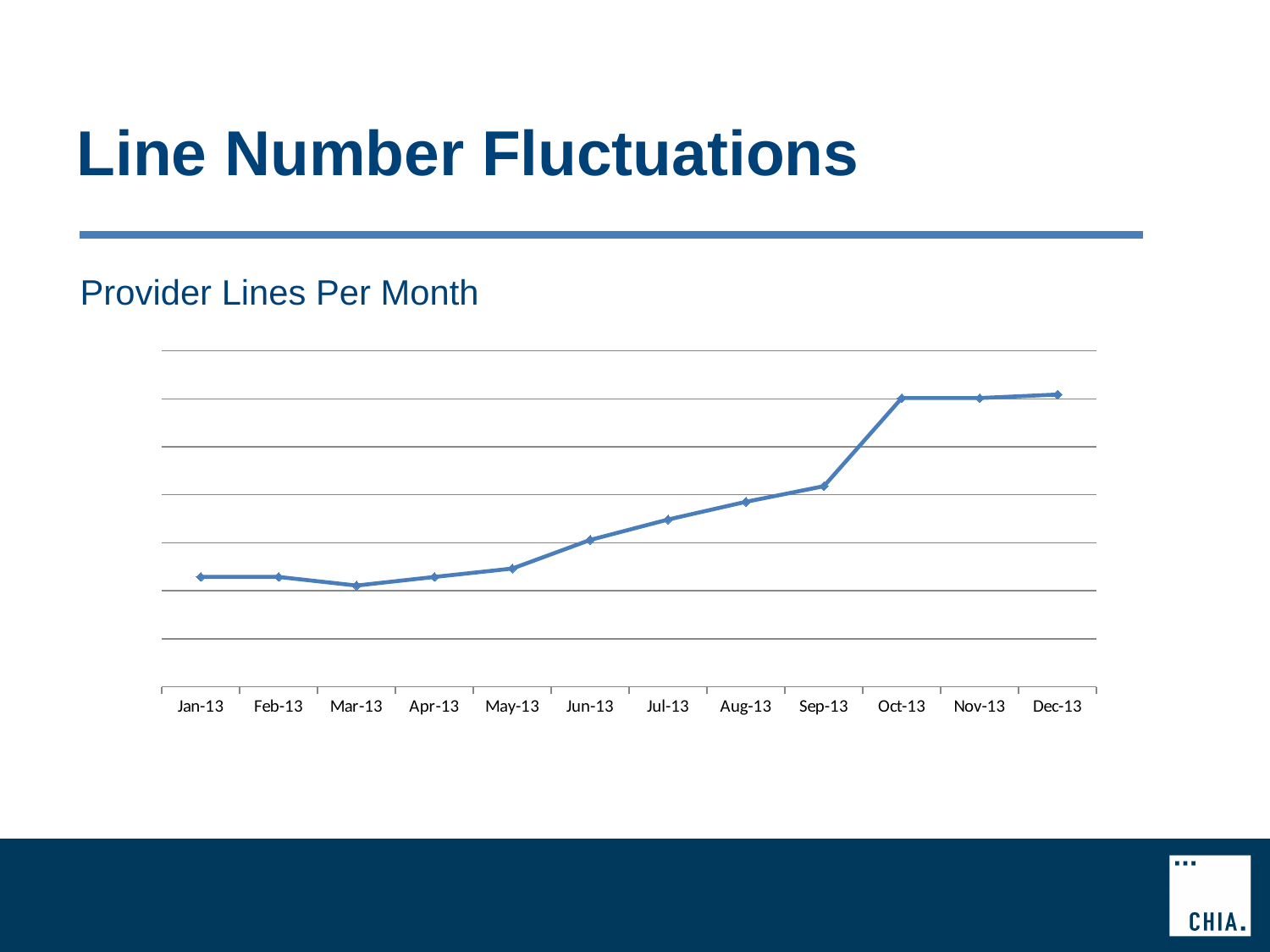
Between which two consecutive months does the line show its steepest increase? Sep-13 to Oct-13 Do the values generally rise or fall from Jan-13 to Dec-13? rise Which is larger, the value for Jan-13 or the value for Oct-13? Oct-13 Which is larger, the value for May-13 or the value for Aug-13? Aug-13 Which month has the lowest value in the chart? Mar-13 What kind of chart is shown on the slide? line chart What is the title of the chart? Provider Lines Per Month How many months are plotted on the x axis of the chart? 12 Which is larger, the value for Sep-13 or the value for Jun-13? Sep-13 What is the first month shown on the x axis? Jan-13